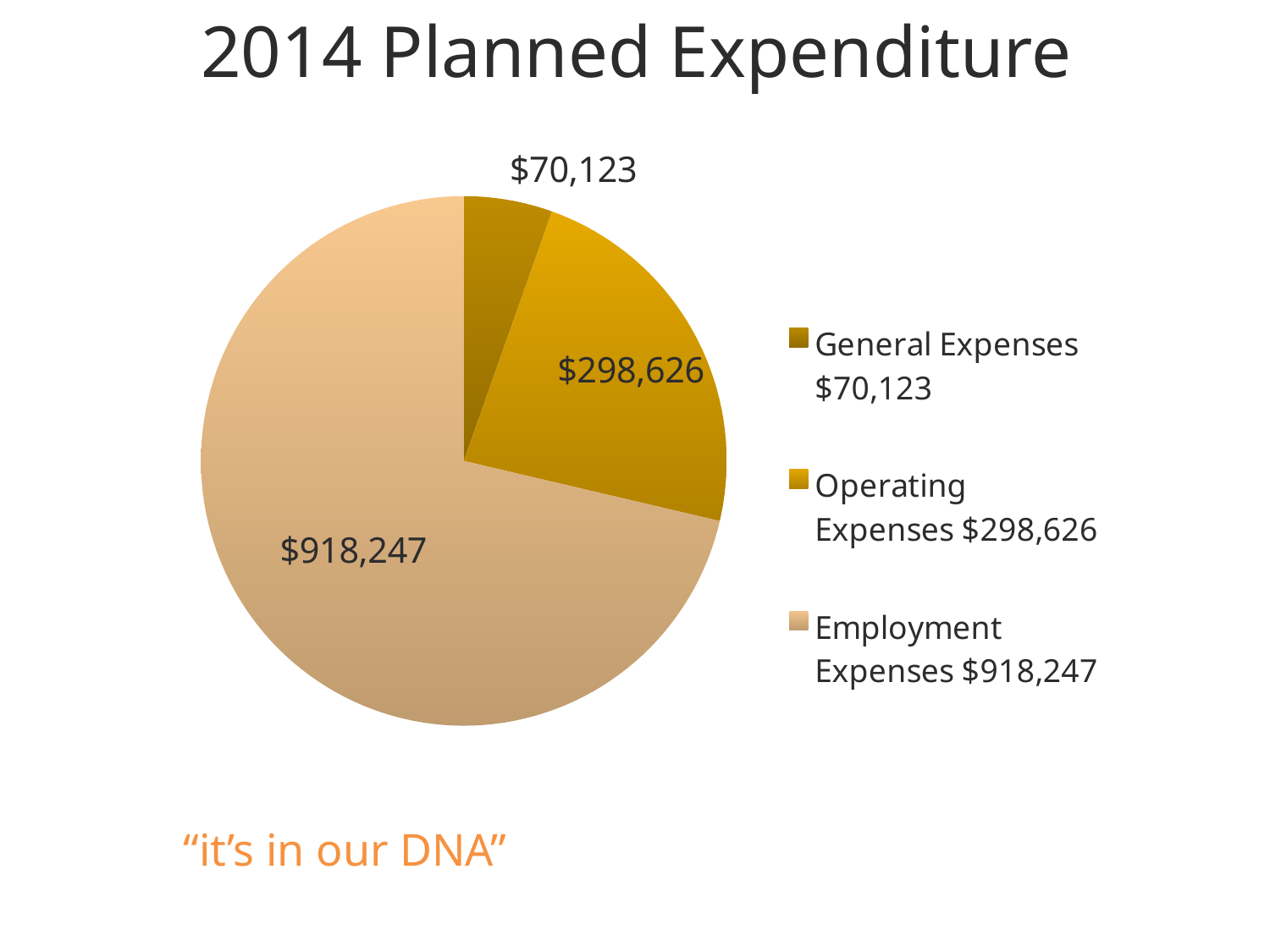
What is the difference between Operating Expenses and General Expenses? $228,503 How many categories are shown in the pie chart? 3 What is the planned expenditure for Operating Expenses? $298,626 Which is larger, Operating Expenses or General Expenses? Operating Expenses Which category has the smallest planned expenditure? General Expenses What type of chart is shown on the slide? Pie chart What is the title of the chart? 2014 Planned Expenditure What is the total planned expenditure across all three categories? $1,286,996 What is the planned expenditure for Employment Expenses? $918,247 How much larger is Employment Expenses than Operating Expenses? $619,621 What is the planned expenditure for General Expenses? $70,123 Which category has the largest planned expenditure? Employment Expenses